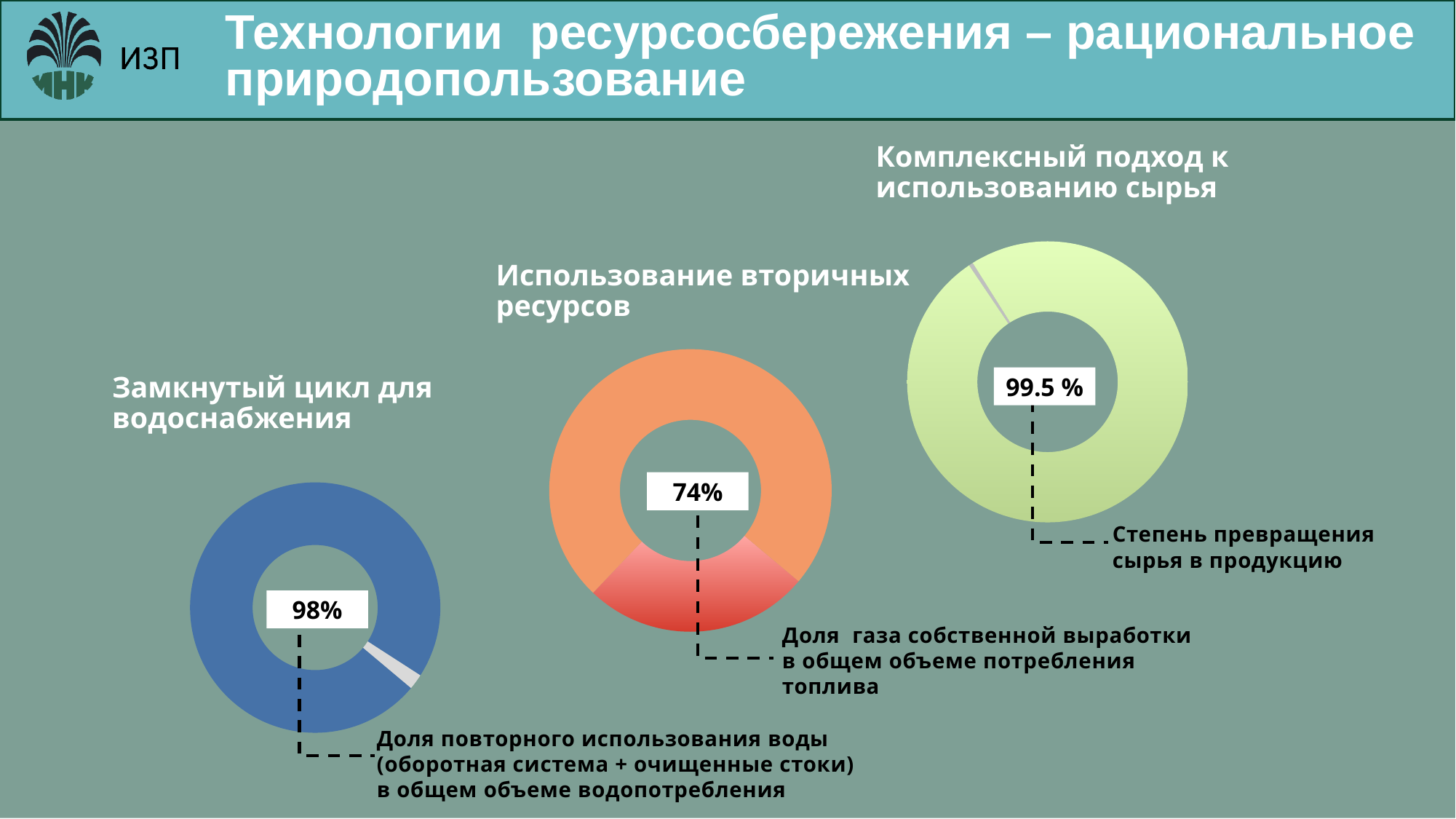
What value is shown in the centre of the 'Замкнутый цикл для водоснабжения' donut chart? 98% What kind of charts are shown on the slide? Donut (pie) charts What is the difference between the value in the 'Комплексный подход к использованию сырья' chart and the value in the 'Замкнутый цикл для водоснабжения' chart? 1.5 percentage points Which of the three donut charts shows the highest value? Комплексный подход к использованию сырья What value is shown in the centre of the 'Использование вторичных ресурсов' donut chart? 74% How many donut charts are on the slide? 3 What value is shown in the centre of the 'Комплексный подход к использованию сырья' donut chart? 99.5 % Which is larger: the value in the 'Замкнутый цикл для водоснабжения' chart or the value in the 'Использование вторичных ресурсов' chart? Замкнутый цикл для водоснабжения What is the difference between the value in the 'Замкнутый цикл для водоснабжения' chart and the value in the 'Использование вторичных ресурсов' chart? 24 percentage points What does the 74% in the 'Использование вторичных ресурсов' chart represent, according to the label on the slide? Доля газа собственной выработки в общем объеме потребления топлива What colour is the main slice of the 'Замкнутый цикл для водоснабжения' donut chart? Blue Which of the three donut charts shows the lowest value? Использование вторичных ресурсов